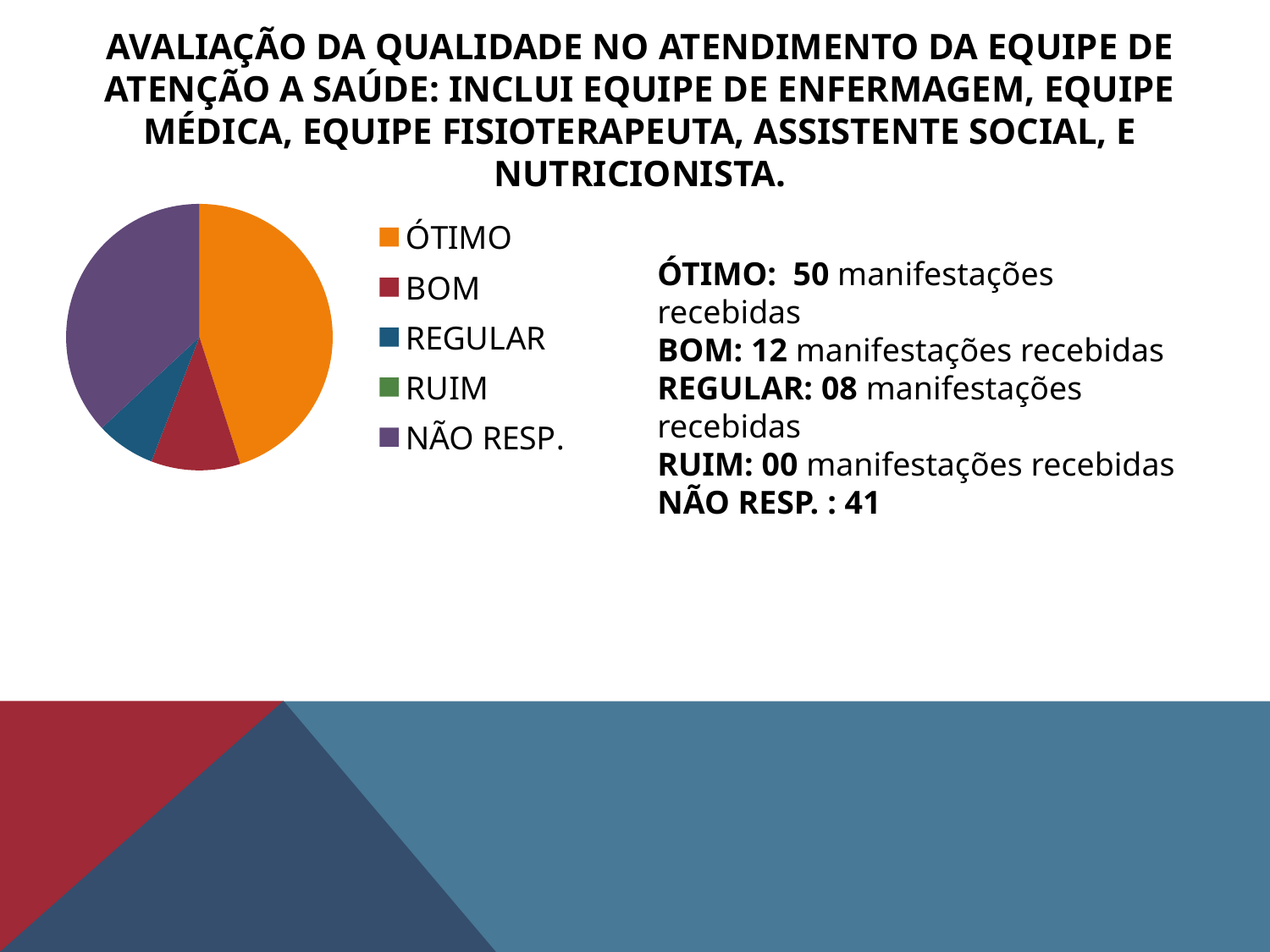
Which is larger, the value for BOM or the value for REGULAR? BOM How many manifestações recebidas are reported for ÓTIMO? 50 Which category has the smallest value? RUIM What kind of chart is shown on the slide? pie chart What is the value for NÃO RESP.? 41 How many manifestações recebidas are reported for BOM? 12 What is the difference between the ÓTIMO and NÃO RESP. values? 9 How many manifestações recebidas are reported for RUIM? 00 Which category has the largest slice of the pie chart? ÓTIMO How many categories does the pie chart's legend list? 5 What colour is the ÓTIMO slice in the pie chart? orange How many manifestações recebidas are reported for REGULAR? 08